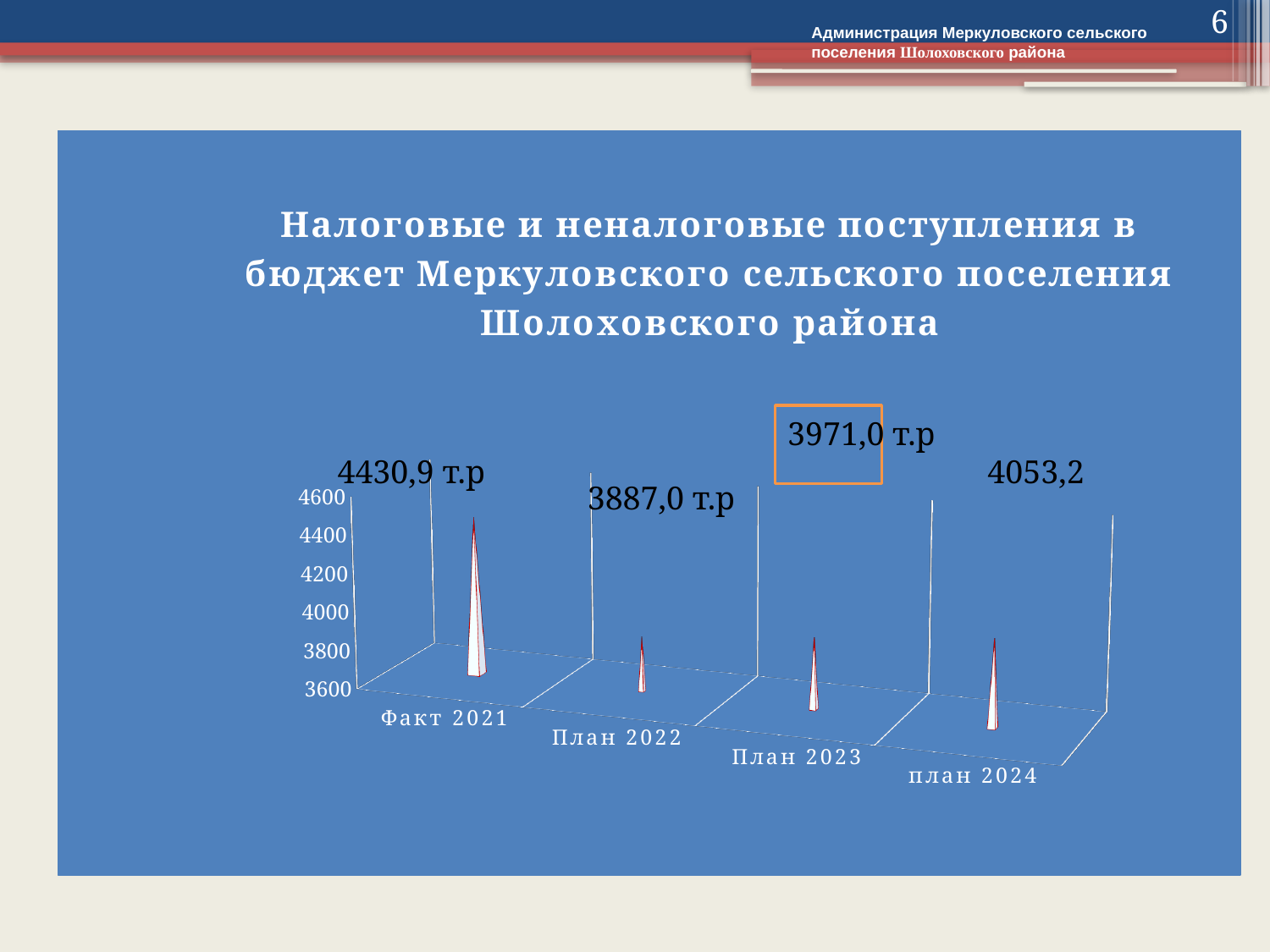
What is the value shown for План 2022? 3887,0 т.р Is the value for План 2022 greater or less than 4000? less What is the difference between the values for Факт 2021 and План 2022? 543,9 What is the value shown for Факт 2021? 4430,9 т.р What is the value shown for План 2023? 3971,0 т.р What is the value shown for план 2024? 4053,2 How many categories are shown on the x axis? 4 What is the difference between the values for план 2024 and План 2023? 82,2 Which category has the lowest value? План 2022 Which is larger, the value for План 2023 or the value for План 2022? План 2023 Do the values rise or fall from План 2022 to план 2024? rise Which category has the highest value? Факт 2021